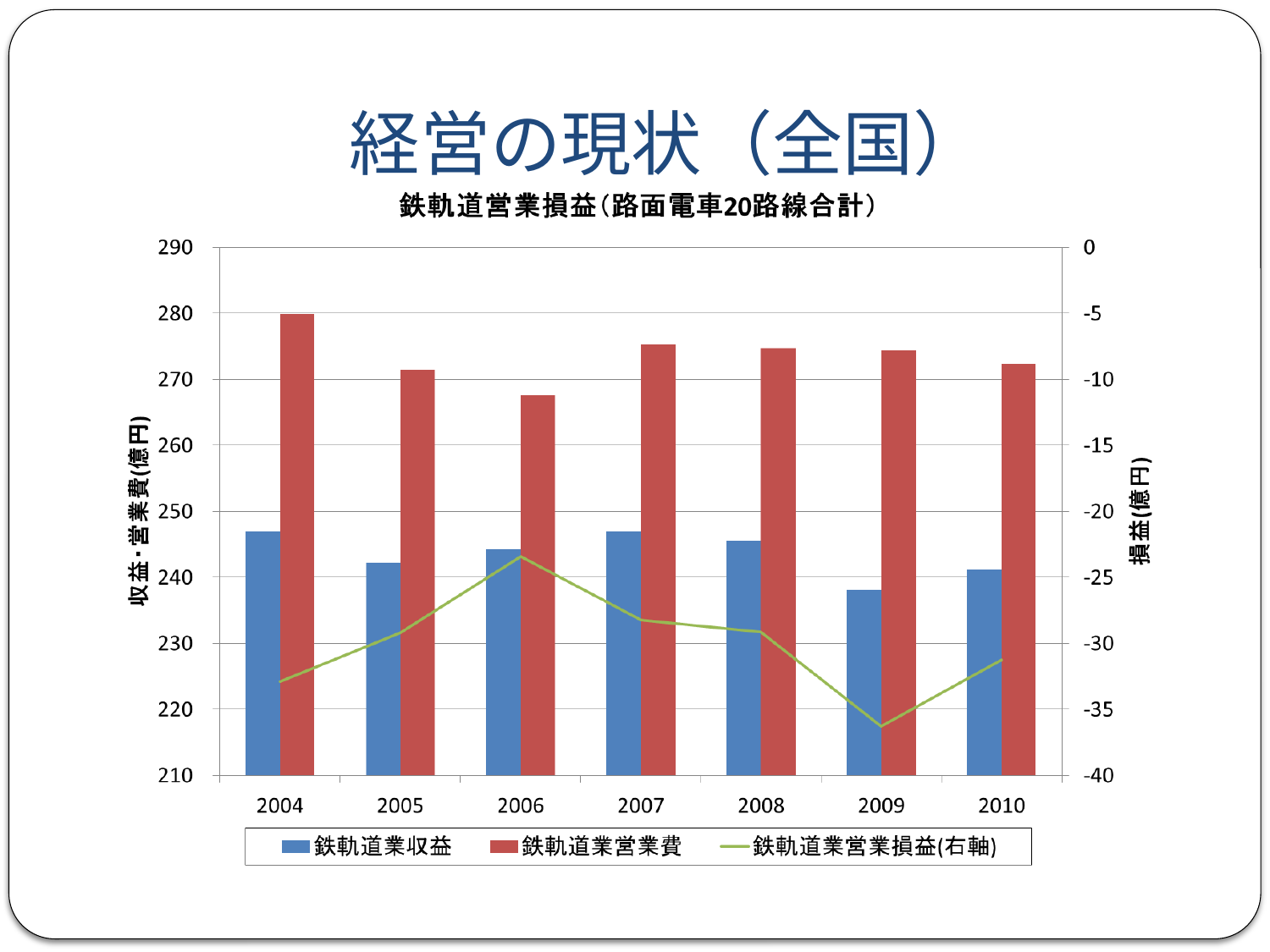
Which is larger in 2006, 鉄軌道業収益 or 鉄軌道業営業費? 鉄軌道業営業費 How many series does the legend list? 3 In which year is 鉄軌道業営業費 highest? 2004 In which year is 鉄軌道業収益 lowest? 2009 In which year does the 鉄軌道業営業損益(右軸) line reach its lowest point? 2009 Is the value of 鉄軌道業収益 in 2009 greater or less than 240? less Does 鉄軌道業収益 rise or fall from 2007 to 2009? fall How many years are shown on the x axis? 7 What kind of chart is shown on the slide? A combined bar and line chart In which year is 鉄軌道業営業費 lowest? 2006 In which year does the 鉄軌道業営業損益(右軸) line reach its highest point? 2006 Is the value of 鉄軌道業営業費 in 2004 greater or less than 270? greater